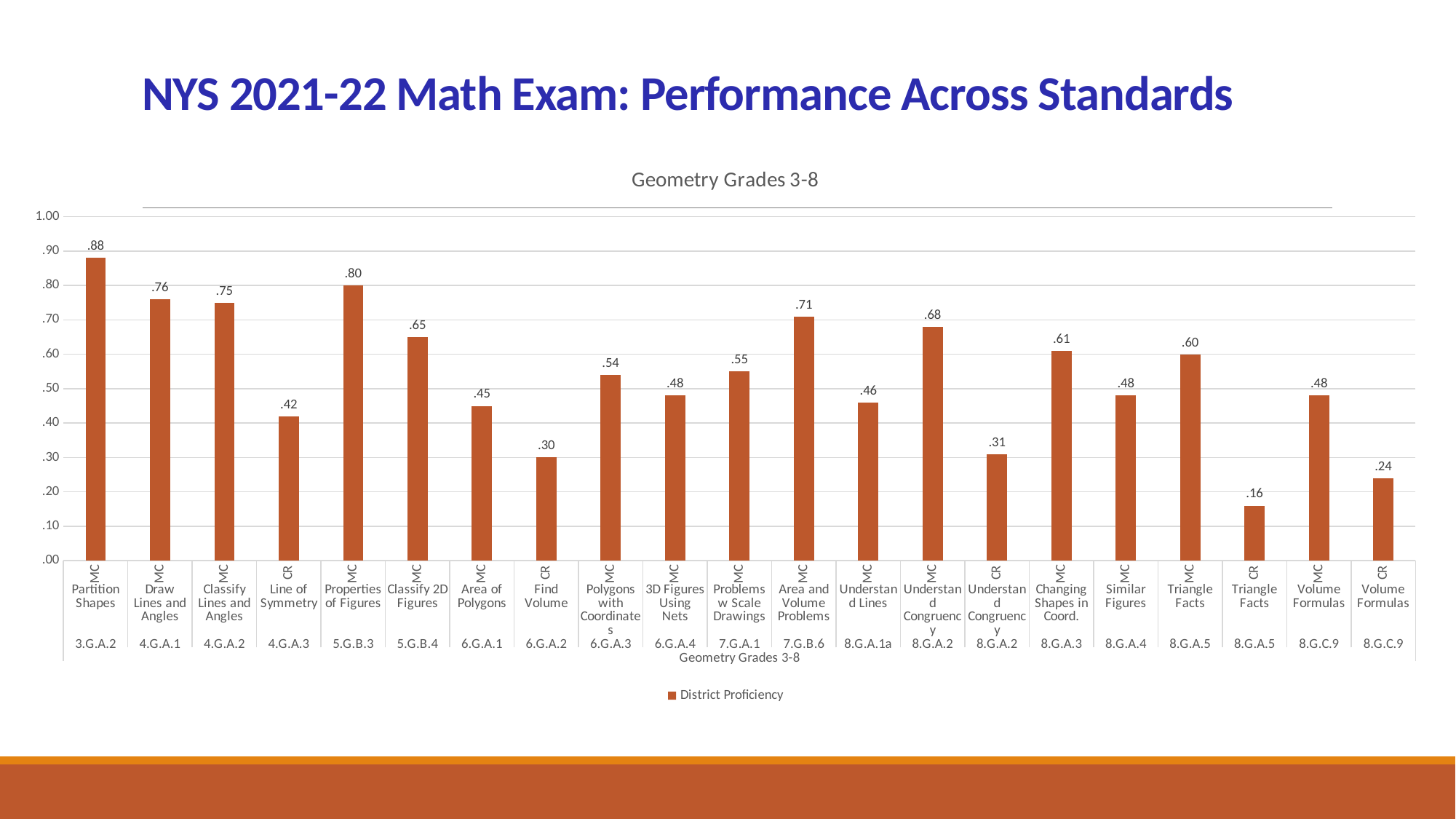
What is the value for Area and Volume Problems (7.G.B.6)? .71 What type of chart is shown on the slide? Bar chart Which standard has the lowest District Proficiency value? Triangle Facts (CR, 8.G.A.5) What is the title of the chart? Geometry Grades 3-8 What is the District Proficiency value for Partition Shapes (3.G.A.2)? .88 Is the value for Line of Symmetry (4.G.A.3) greater or less than .50? less What is the difference between the MC and CR values for Understand Congruency (8.G.A.2)? .37 Which is larger: the value for Properties of Figures (5.G.B.3) or Classify 2D Figures (5.G.B.4)? Properties of Figures (5.G.B.3) How many bars are plotted in the chart? 21 What is the value shown for Find Volume (CR, 6.G.A.2)? .30 Which standard has the highest District Proficiency value? Partition Shapes (3.G.A.2) How many series does the legend list? 1